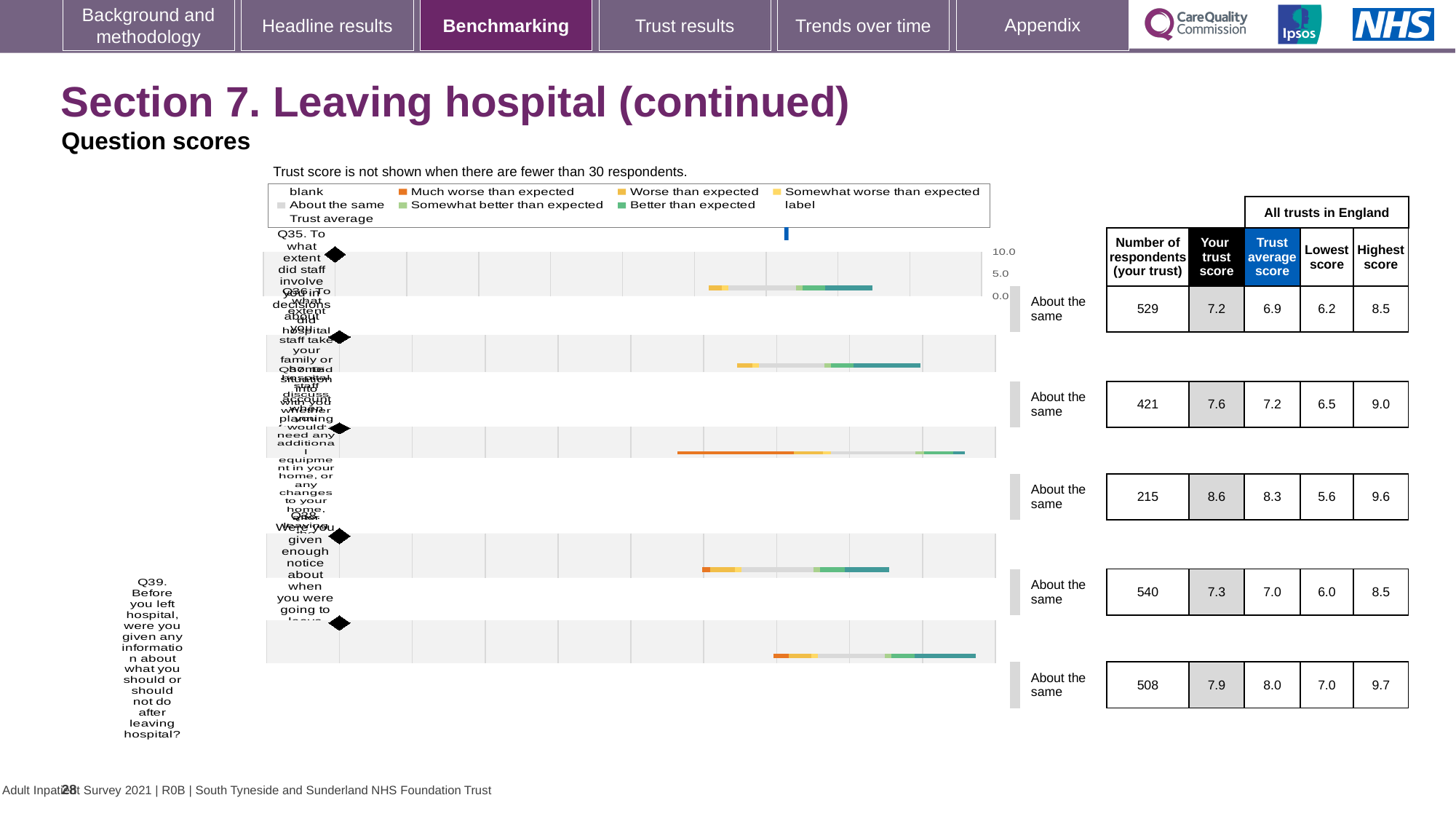
What is the 'Your trust score' value for Q39? 7.9 What is the number of respondents for the first question row (Q35)? 529 What benchmark category is shown next to every question row in the chart? About the same What is the highest 'Your trust score' value shown in the table? 8.6 For Q39, which is larger: the trust's own score or the trust average score? Trust average score According to the note above the chart, when is the trust score not shown? When there are fewer than 30 respondents What is the trust average score for Q39? 8.0 What is the highest score across all trusts in England for Q39? 9.7 How many question rows are plotted in the chart? 5 What is the number of respondents for Q39 (Before you left hospital, were you given any information about what you should or should not do after leaving hospital?)? 508 For Q39, what is the difference between the highest score and the lowest score across all trusts in England? 2.7 What kind of chart is used to show the question scores on this slide? bar chart